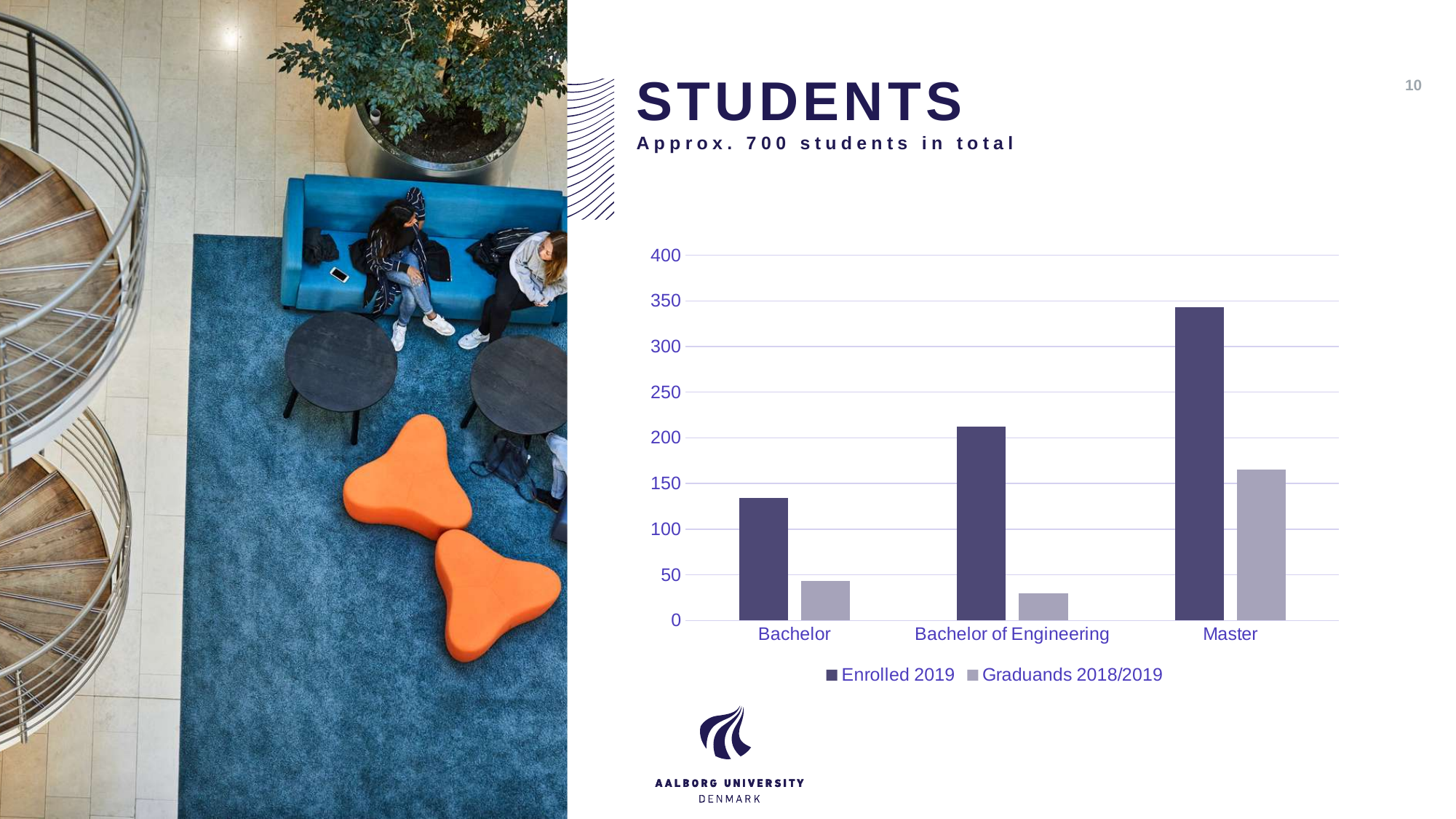
Which is larger: the Graduands 2018/2019 value for Master or the Enrolled 2019 value for Bachelor? Graduands 2018/2019 for Master How many series does the chart's legend list? 2 Which category has the lowest Enrolled 2019 value? Bachelor What are the two series named in the chart's legend? Enrolled 2019 and Graduands 2018/2019 Is the Enrolled 2019 value for Bachelor of Engineering greater or less than 200? greater Which category has the lowest Graduands 2018/2019 value? Bachelor of Engineering What kind of chart is shown on the slide? bar chart Which category has the highest Enrolled 2019 value? Master Is the Enrolled 2019 value for Master greater or less than 300? greater How many categories are shown on the x axis of the chart? 3 Is the Graduands 2018/2019 value for Bachelor greater or less than 50? less Do the Enrolled 2019 values rise or fall from Bachelor to Master along the x axis? rise